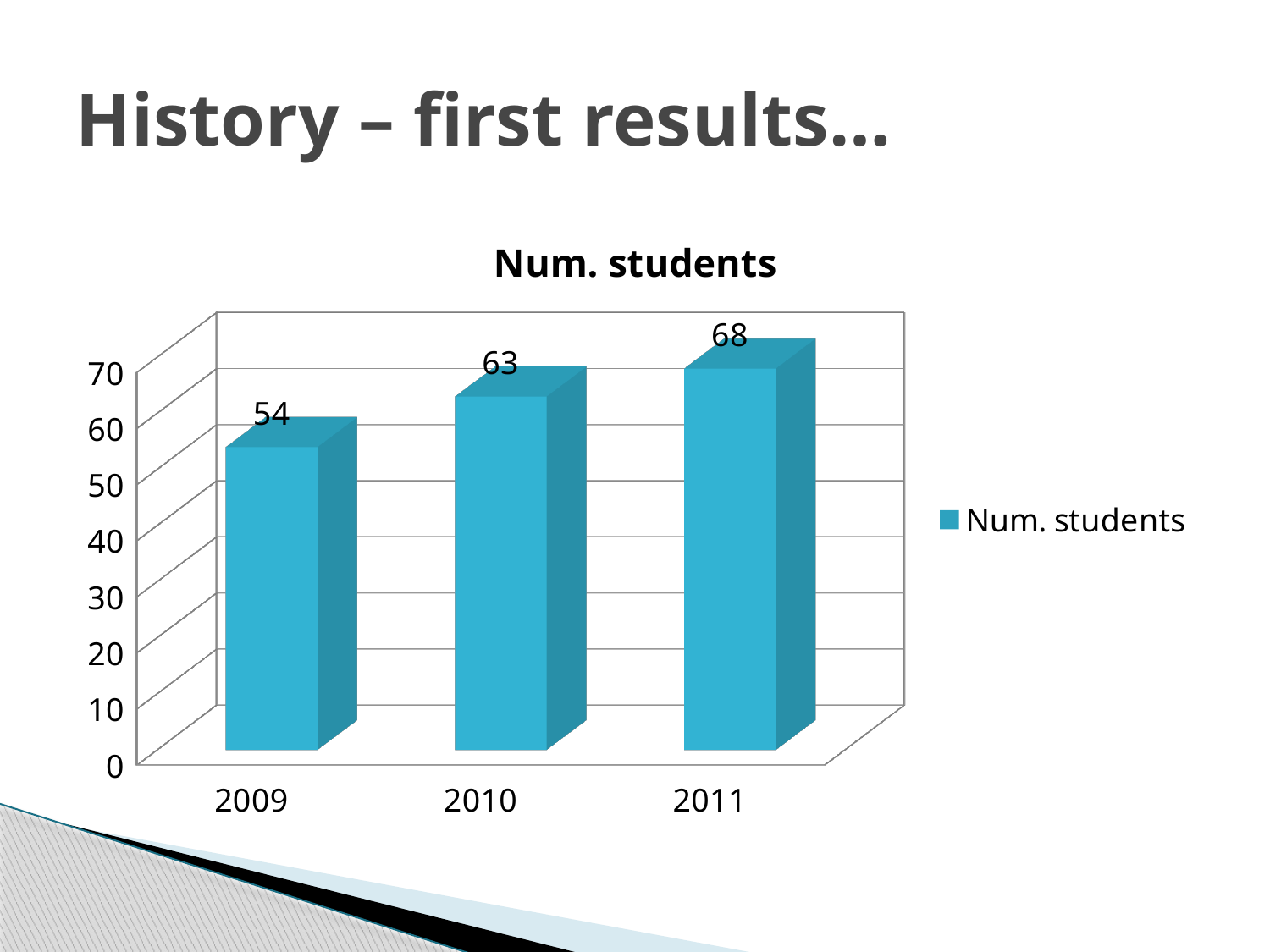
What is the value for 2011? 68 What is the value for 2009? 54 What is the difference between the values for 2010 and 2009? 9 Do the values rise or fall from 2009 to 2011? rise Which year has the highest number of students? 2011 What is the difference between the values for 2011 and 2009? 14 Which is larger, the value for 2010 or the value for 2011? 2011 Which year has the lowest number of students? 2009 How many years are shown on the x axis? 3 What is the value for 2010? 63 How many series does the legend list? 1 What kind of chart is shown? bar chart